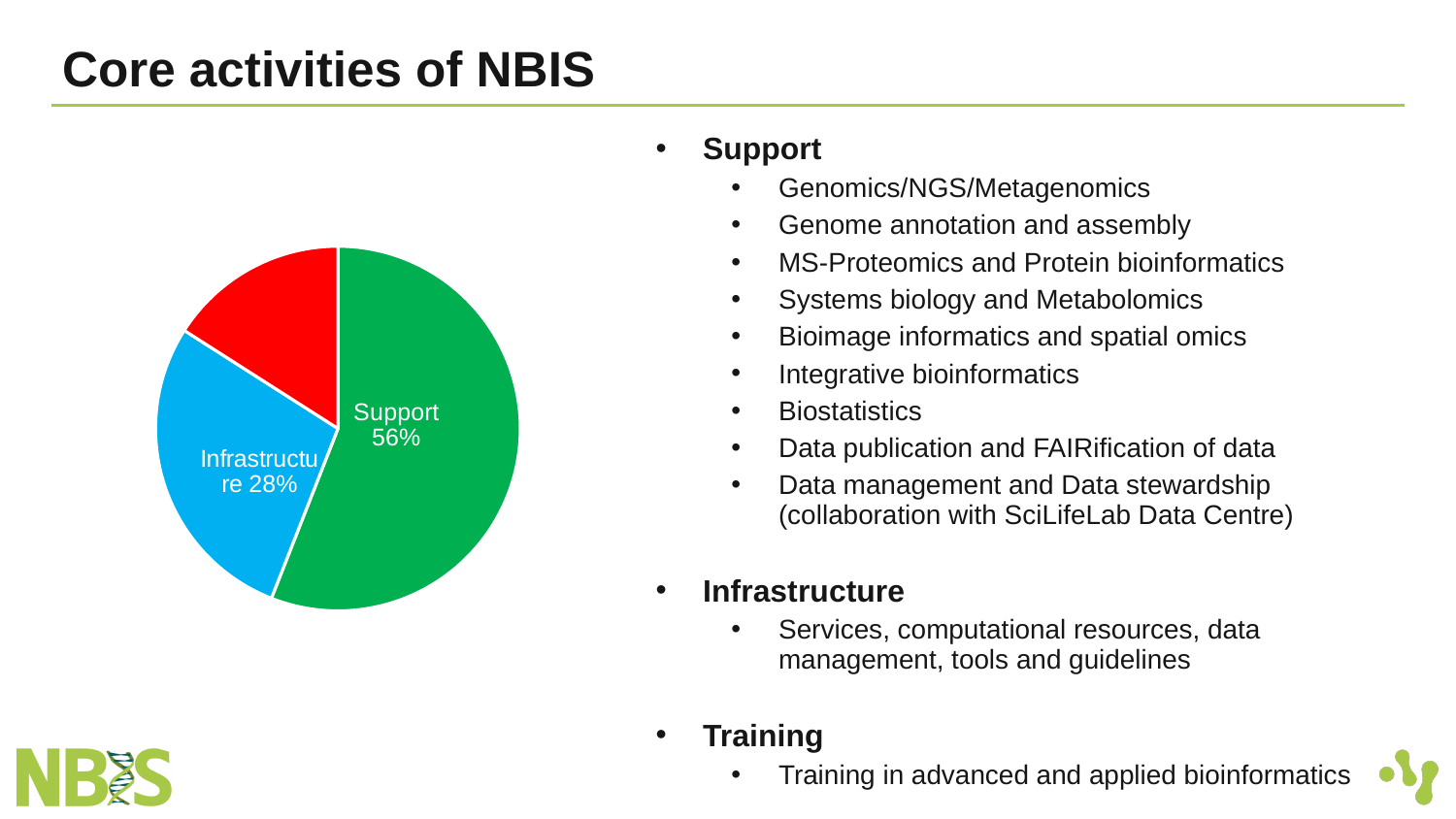
What colour is the Support slice of the pie chart? green Which is larger, the Support slice or the Infrastructure slice? Support Is the Support share greater or less than 50%? greater Which slice of the pie chart is the largest? Support What kind of chart is shown on the slide? pie chart How many slices does the pie chart have? 3 What share of the pie does the Infrastructure slice represent? 28% By how many percentage points does the Support share exceed the Infrastructure share? 28 percentage points What share of the pie does the Support slice represent? 56% What colour is the Infrastructure slice of the pie chart? blue Is the Infrastructure share greater or less than 30%? less